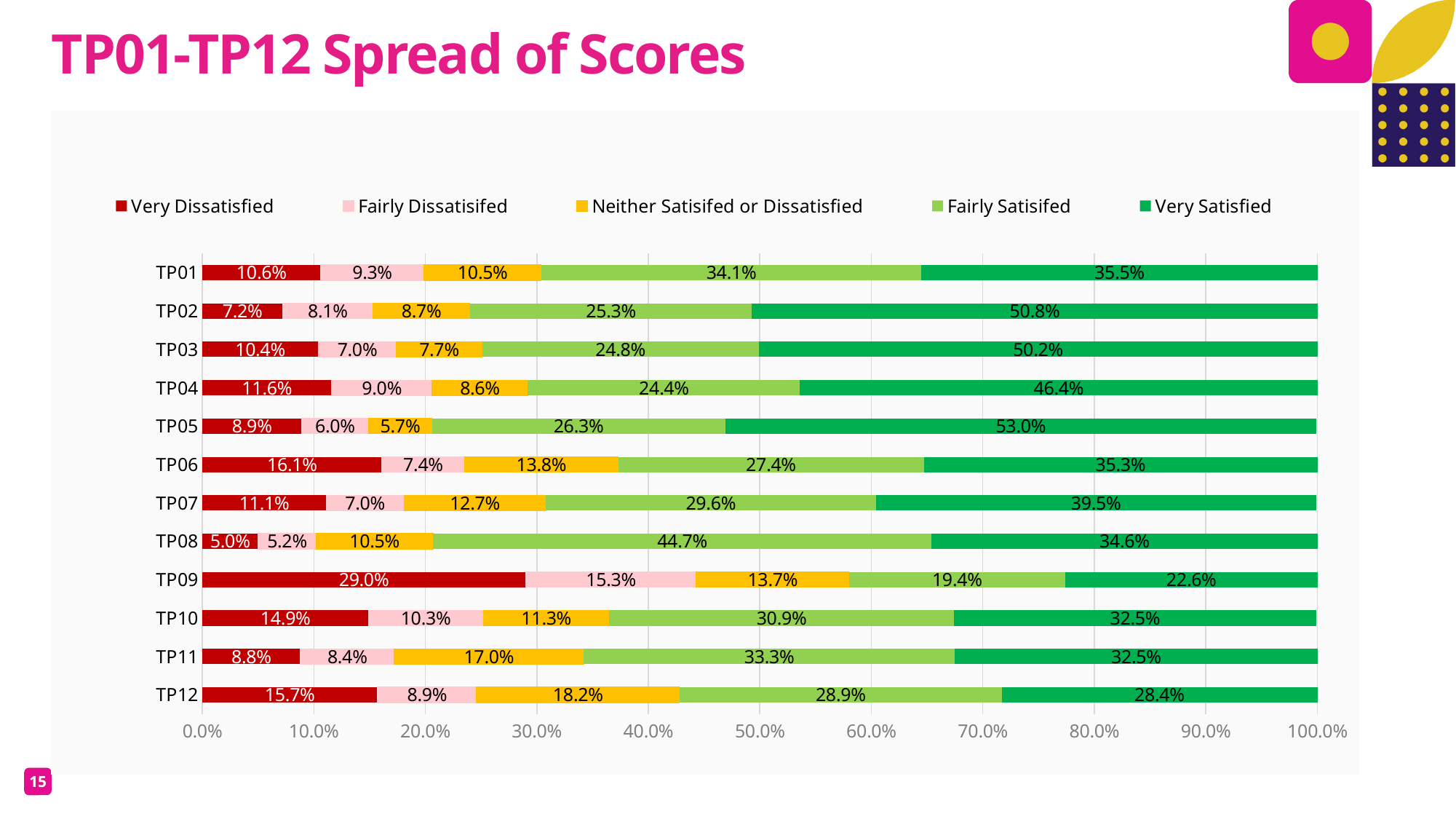
How many categories (TP groups) are plotted on the chart? 12 What is the Neither Satisfied or Dissatisfied value for TP12? 18.2% What is the total of the stacked bar for TP01? 100.0% What is the Very Dissatisfied value for TP09? 29.0% Which has the larger Very Dissatisfied value, TP06 or TP10? TP06 How many series does the legend list? 5 Which category has the lowest Very Dissatisfied value? TP08 What is the difference between the Very Satisfied values for TP02 and TP01? 15.3% What is the title of the chart? TP01-TP12 Spread of Scores What type of chart is shown on the slide? Stacked bar chart Which category has the highest Very Satisfied value? TP05 What is the Very Satisfied value for TP05? 53.0%